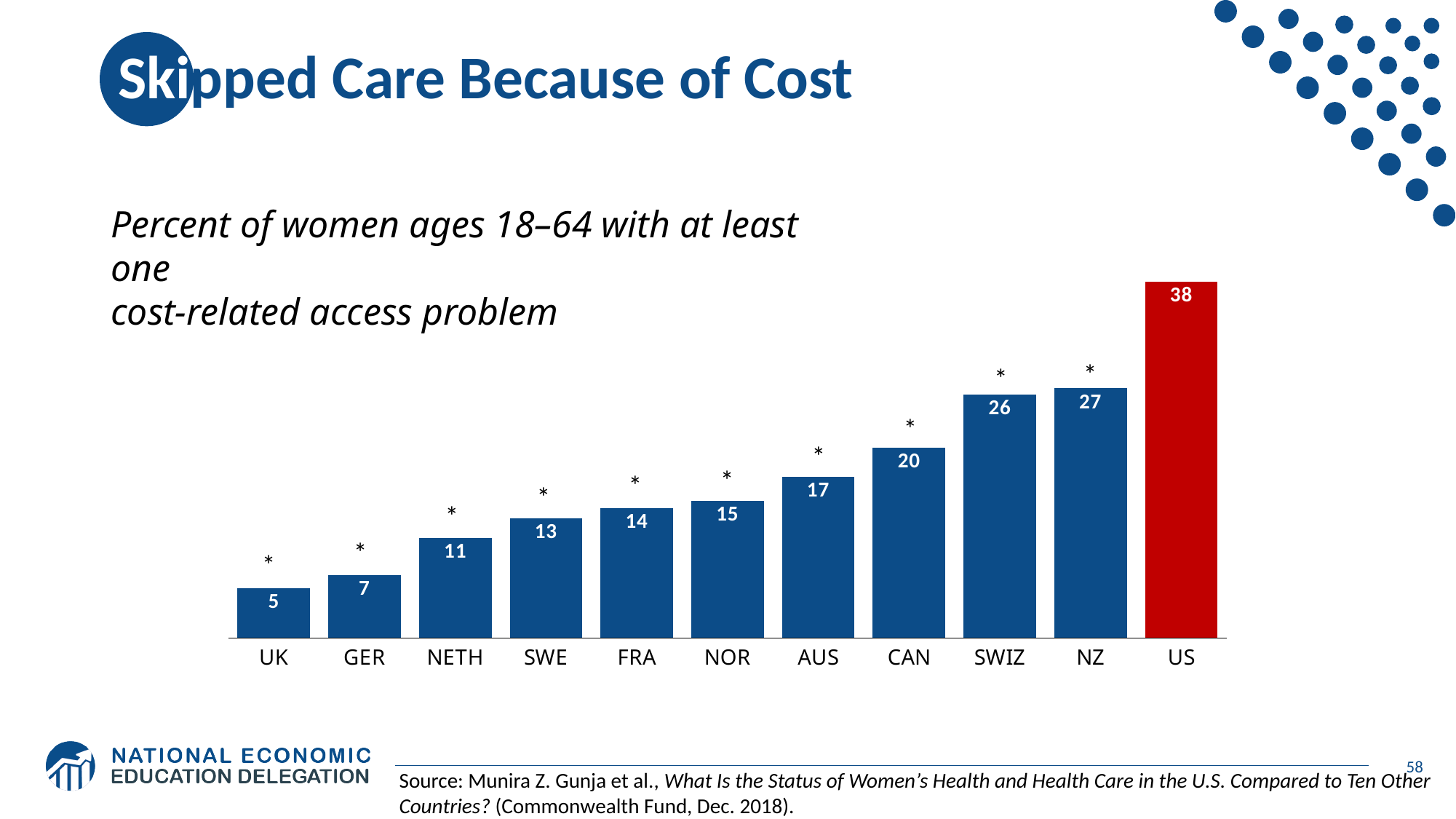
What is the value for Germany (GER)? 7 Which bar is coloured red rather than blue? US Which country has the highest value? US What is the value for the US? 38 How many countries are shown in the chart? 11 What kind of chart is shown on the slide? Bar chart Which has a larger value, AUS or FRA? AUS What is the value for Canada (CAN)? 20 Do the values rise or fall from left to right along the x axis? Rise What is the difference between the values for the US and NZ? 11 What is the difference between the values for SWIZ and NETH? 15 Which country has the lowest value? UK